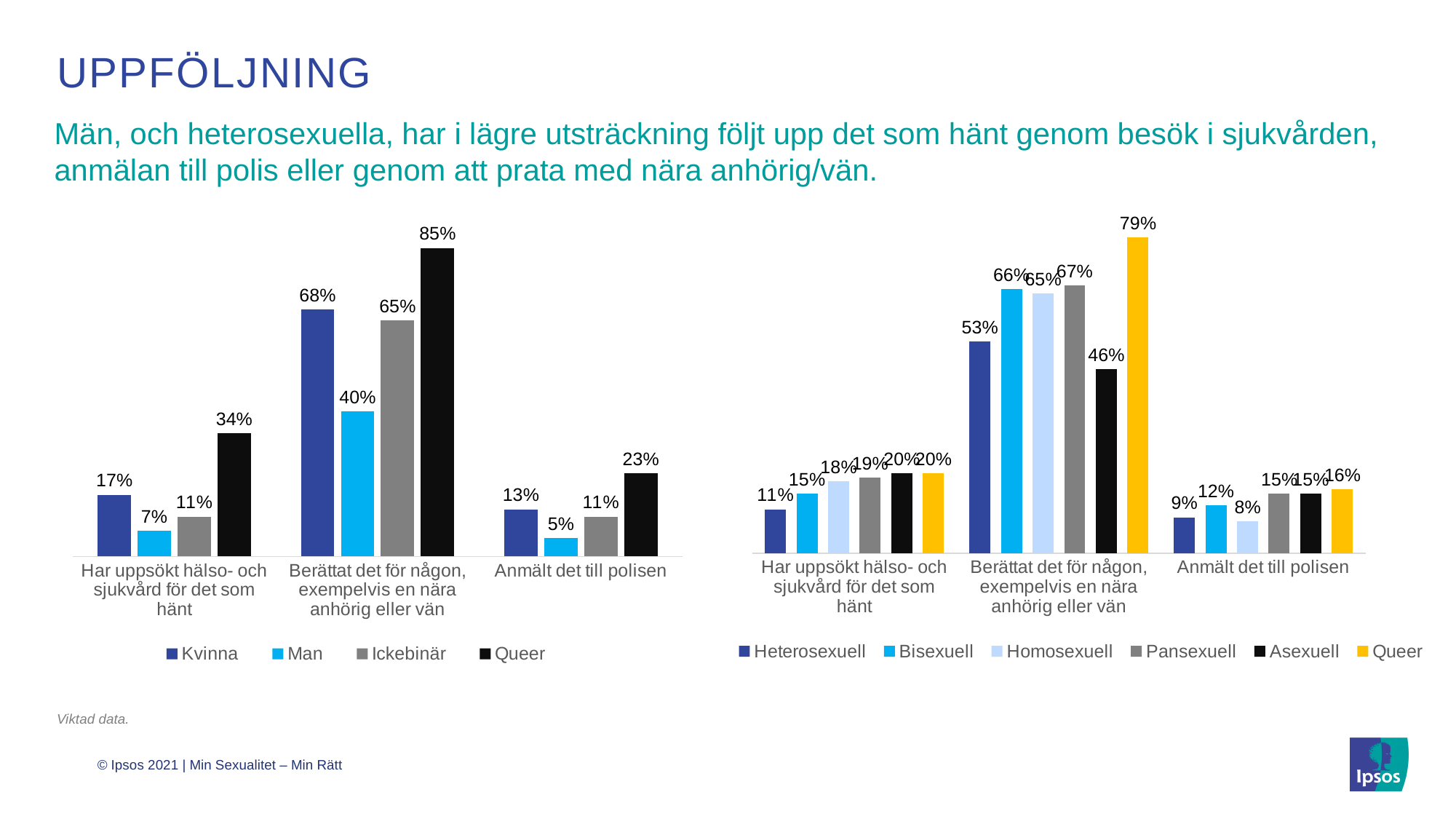
In the right chart, what is the value for Heterosexuell in the category 'Berättat det för någon, exempelvis en nära anhörig eller vän'? 53% In the left chart, which series has the highest value in the category 'Har uppsökt hälso- och sjukvård för det som hänt'? Queer In the left chart, what is the value for Man in the category 'Anmält det till polisen'? 5% In the right chart, which is larger in the category 'Har uppsökt hälso- och sjukvård för det som hänt': Bisexuell or Heterosexuell? Bisexuell In the left chart, what is the value for Queer in the category 'Berättat det för någon, exempelvis en nära anhörig eller vän'? 85% How many series does the legend of the right chart list? 6 In the right chart, what is the value for Asexuell in the category 'Har uppsökt hälso- och sjukvård för det som hänt'? 20% In the right chart, which series has the lowest value in the category 'Berättat det för någon, exempelvis en nära anhörig eller vän'? Asexuell In the right chart, what is the difference between Queer and Heterosexuell in the category 'Anmält det till polisen'? 7 percentage points In the left chart, what is the difference between Kvinna and Man in the category 'Berättat det för någon, exempelvis en nära anhörig eller vän'? 28 percentage points How many categories are shown on the x axis of the left chart? 3 What kind of chart is the left chart? Bar chart